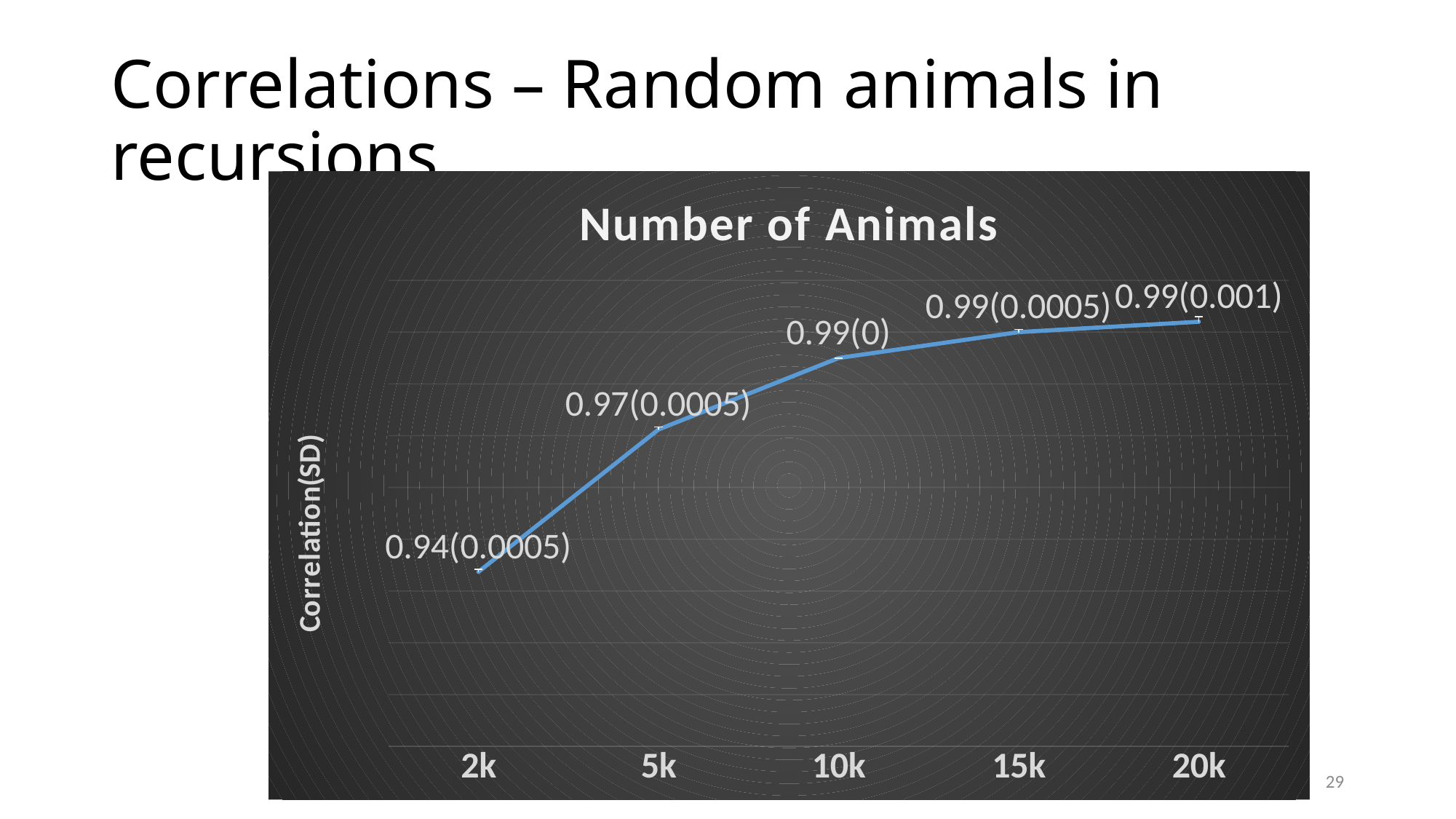
Does the correlation rise or fall as the number of animals increases from 2k to 20k? Rise What is the data label for 5k on the Number of Animals chart? 0.97(0.0005) How many points are plotted on the Number of Animals chart? 5 What is the data label for 10k on the Number of Animals chart? 0.99(0) What is the label on the vertical axis of the chart? Correlation(SD) What is the data label for 2k on the Number of Animals chart? 0.94(0.0005) Which has a higher correlation, 2k or 5k animals? 5k What is the difference between the correlation at 5k and the correlation at 2k? 0.03 What kind of chart is shown on the slide? Line chart Which number of animals has the lowest correlation on the chart? 2k What is the data label for 15k on the Number of Animals chart? 0.99(0.0005) What is the data label for 20k on the Number of Animals chart? 0.99(0.001)